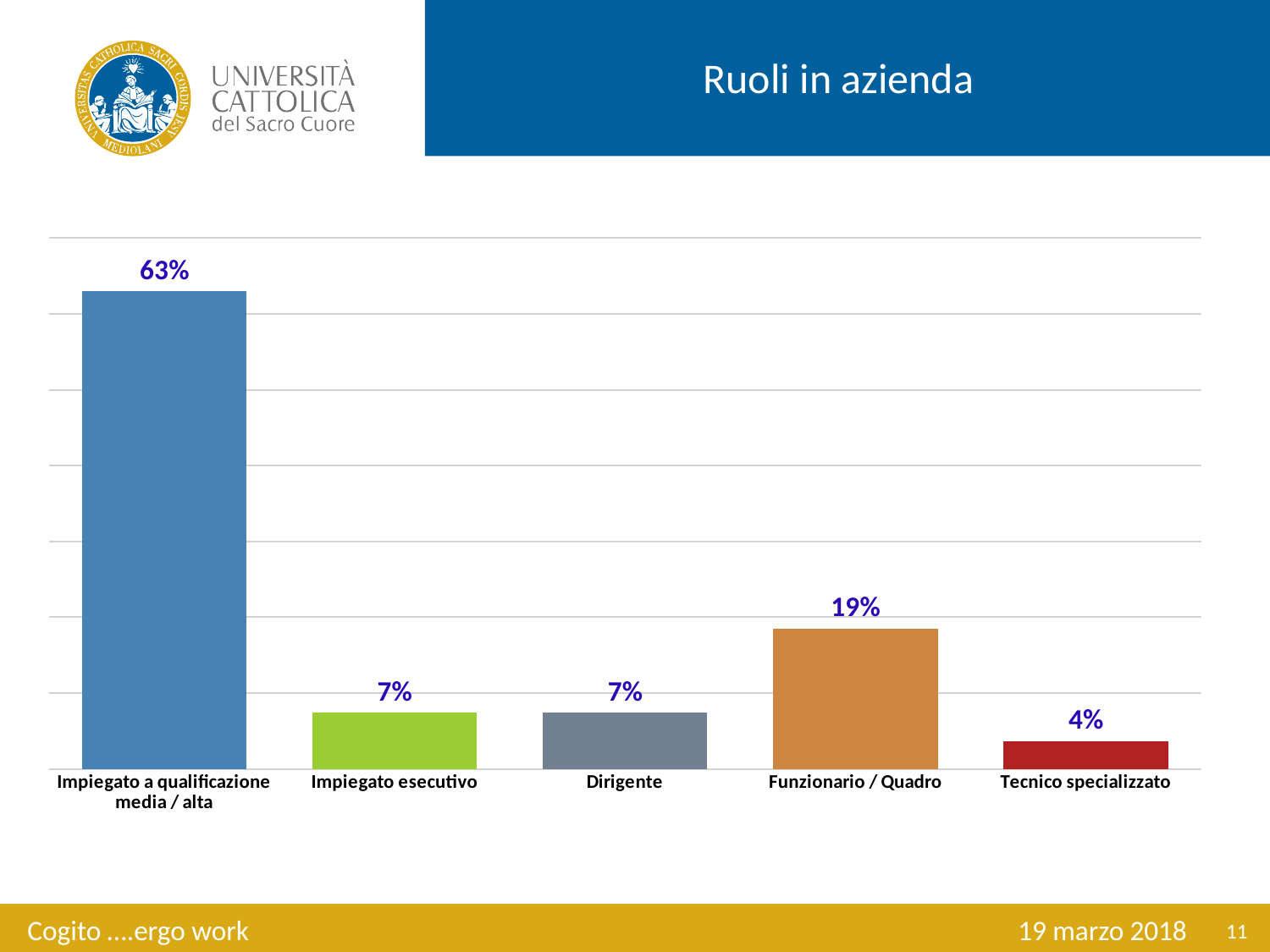
Which is larger, the value for Funzionario / Quadro or the value for Impiegato esecutivo? Funzionario / Quadro What is the difference between the values for Impiegato a qualificazione media / alta and Funzionario / Quadro? 44% What is the value for Funzionario / Quadro? 19% What is the value for Impiegato a qualificazione media / alta? 63% What is the title of the slide containing the chart? Ruoli in azienda Which category has the lowest value? Tecnico specializzato What is the value for Dirigente? 7% What is the value for Tecnico specializzato? 4% Which category has the highest value? Impiegato a qualificazione media / alta What kind of chart is shown on the slide? Bar chart What is the difference between the values for Funzionario / Quadro and Tecnico specializzato? 15% How many categories are shown in the chart? 5